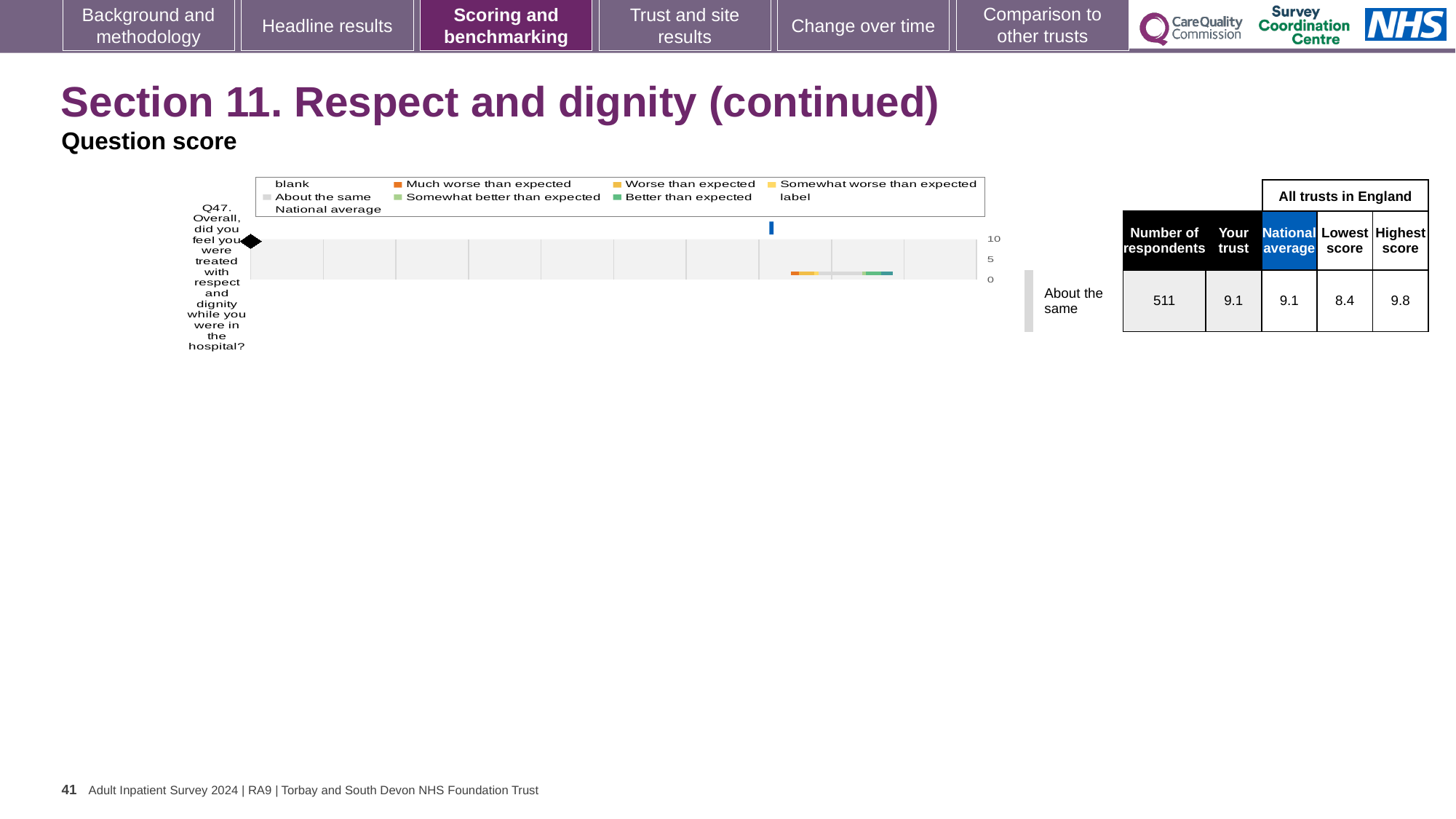
What is the difference between the highest score and the lowest score for Q47? 1.4 How many respondents are listed for Q47? 511 Which question number is plotted on the chart? Q47 What is the highest score among all trusts in England for Q47? 9.8 What is the lowest score among all trusts in England for Q47? 8.4 How many survey questions are plotted on the chart? 1 What is the national average score for Q47? 9.1 What is the 'Your trust' score for Q47? 9.1 Is the national average marker for Q47 greater or less than 5 on the score axis? greater What kind of chart is used to show the Q47 question score? bar chart What is the highest tick value shown on the chart's score axis? 10 Which benchmarking category is Q47 placed in? About the same